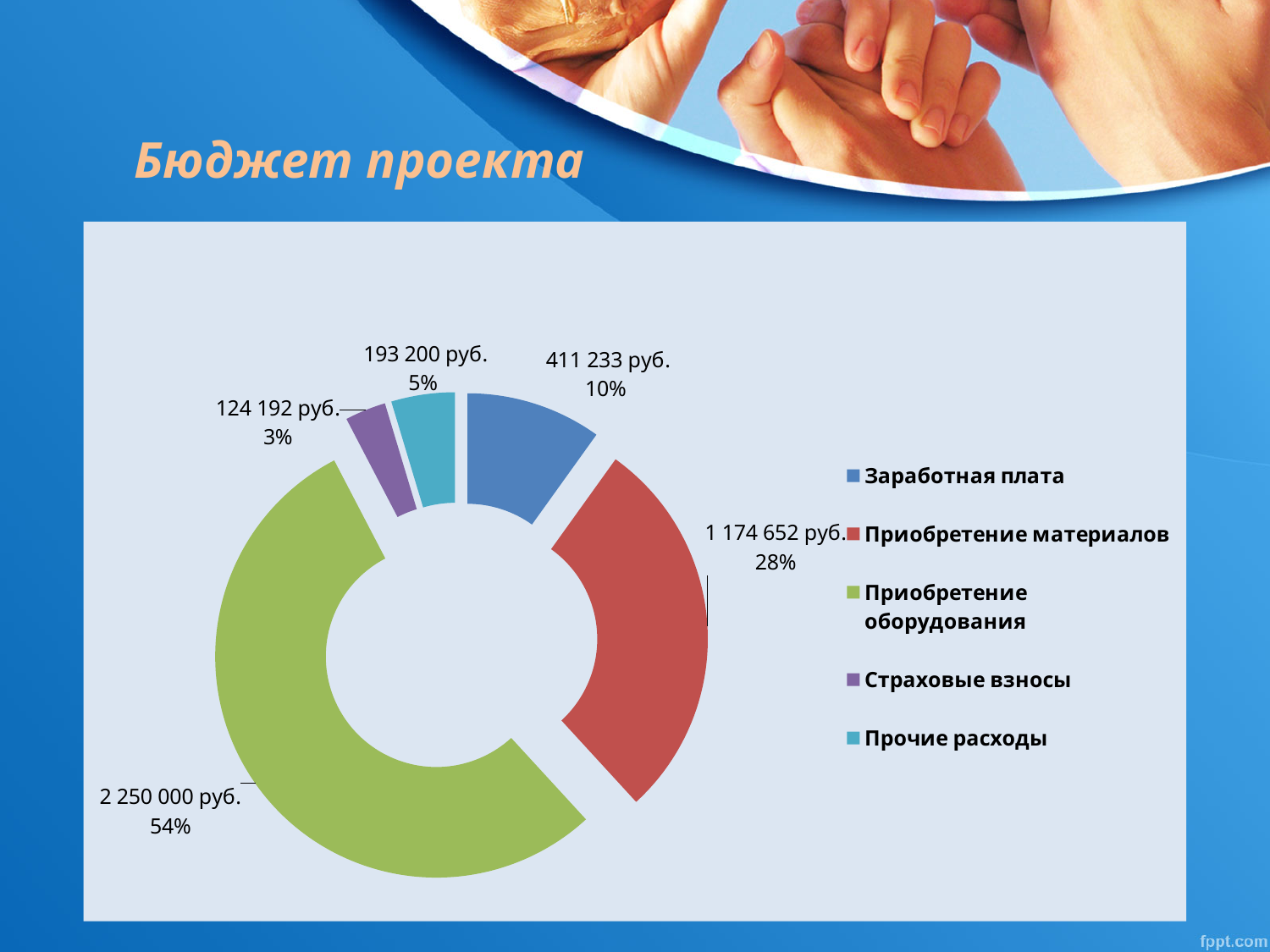
What share of the budget does Приобретение оборудования take? 54% What is the value for Прочие расходы? 193 200 руб. What share of the budget does Приобретение материалов take? 28% What kind of chart is shown on the slide? Doughnut (pie) chart What is the value for Страховые взносы? 124 192 руб. Which category has the largest share of the budget? Приобретение оборудования Which is larger, Заработная плата or Прочие расходы? Заработная плата What is the title of the slide containing the chart? Бюджет проекта Which category has the smallest share of the budget? Страховые взносы What is the value for Приобретение оборудования? 2 250 000 руб. How many categories does the chart show? 5 What is the value for Заработная плата? 411 233 руб.